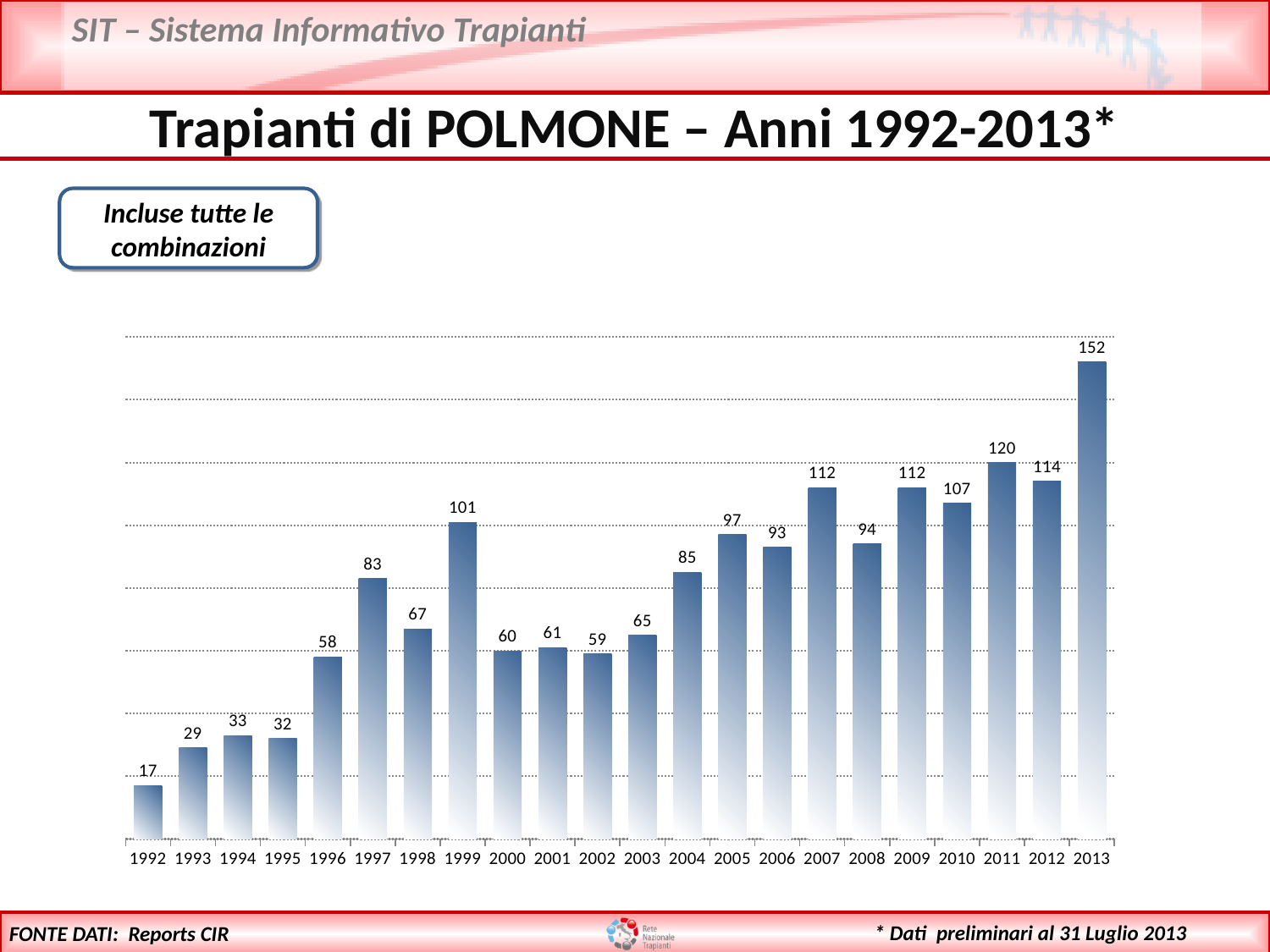
How many years are shown on the x axis? 22 What is the difference between the values for 1997 and 1998? 16 What is the title of the slide's chart? Trapianti di POLMONE – Anni 1992-2013* What is the value for 1999? 101 What kind of chart is shown on the slide? bar chart What is the value for 2013? 152 Do the values generally rise or fall from 1992 to 2013? rise Which is larger, the value for 2011 or the value for 2010? 2011 What is the value for 1992? 17 What is the difference between the values for 2013 and 2012? 38 Which year has the highest value? 2013 Which year has the lowest value? 1992